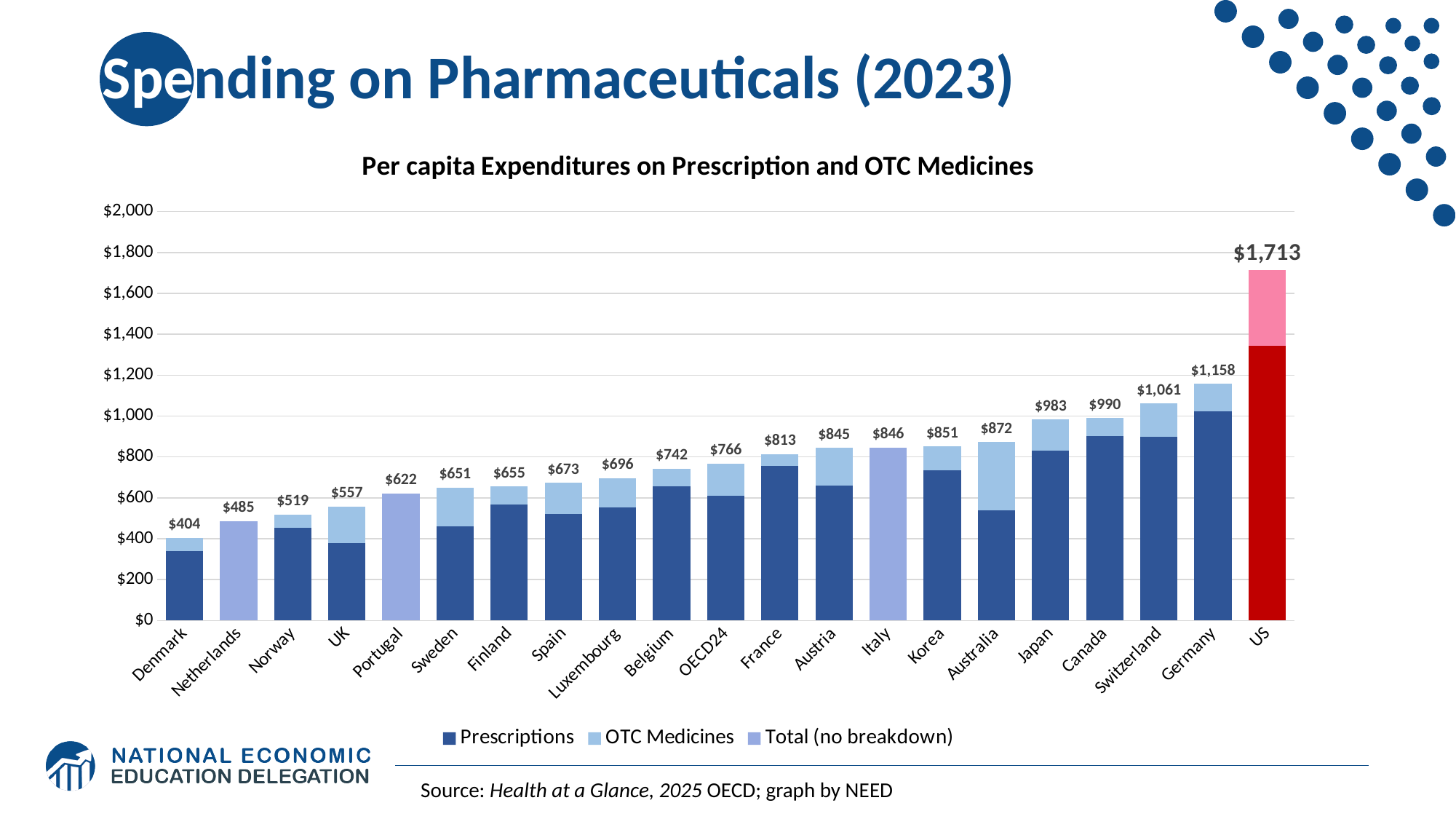
Is the Prescriptions value for Australia greater or less than $600? less What is the difference between the Netherlands total and the Denmark total? $81 What is the total per capita expenditure shown for Germany? $1,158 Which has a larger total, Switzerland or Canada? Switzerland How many countries or groups are shown on the x axis? 21 What is the value shown for OECD24? $766 Which country has the lowest per capita expenditure on the chart? Denmark Do the total values rise or fall moving from left to right along the x axis? rise How many series does the legend list? 3 What is the difference between the US total and the Germany total? $555 What is the total per capita expenditure shown for the US? $1,713 Which country has the highest per capita expenditure on the chart? US